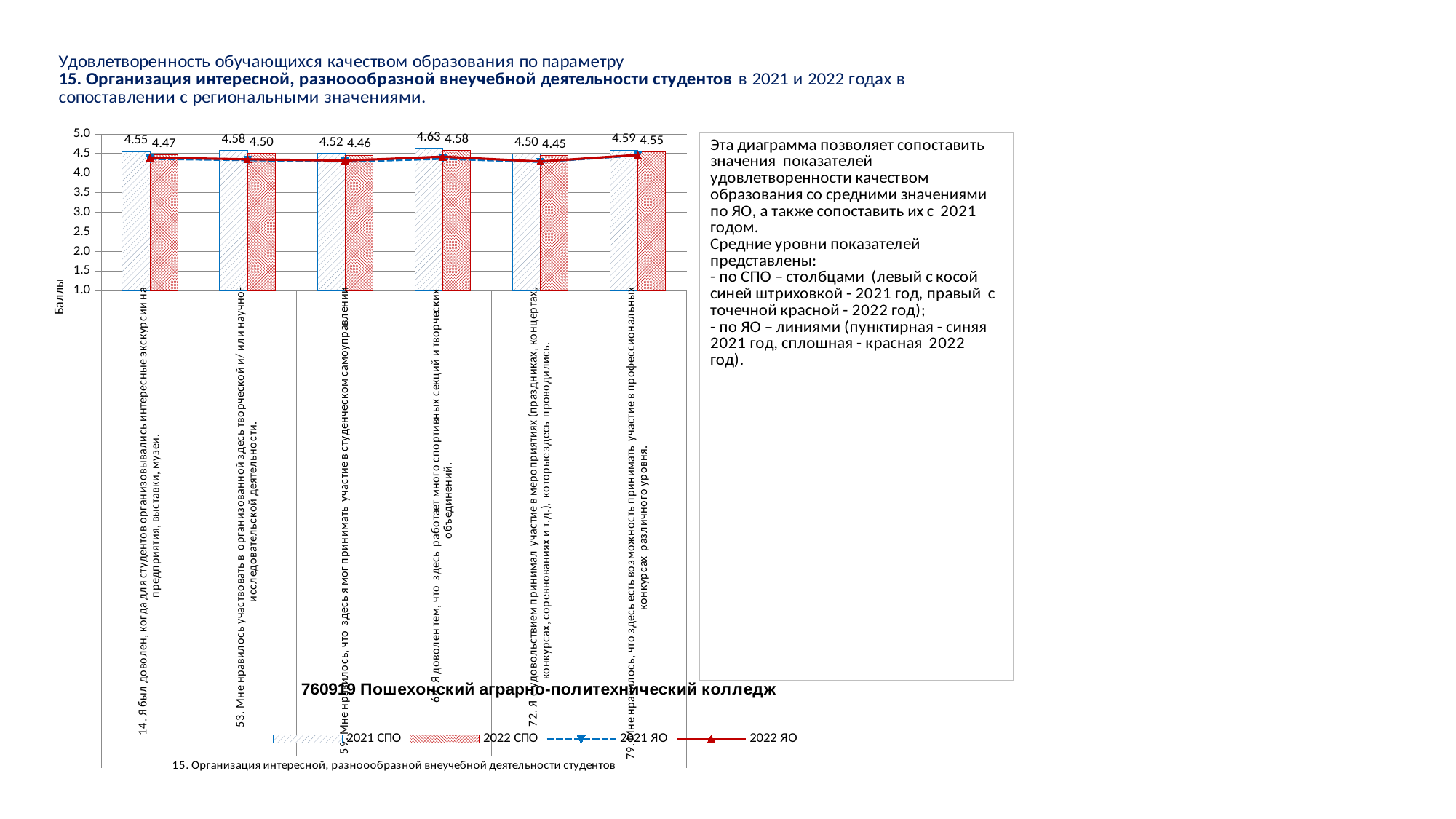
How many statements (categories) are shown on the x axis? 6 What is the difference between the 2021 СПО and 2022 СПО values for statement 53? 0.08 How many series does the legend list? 4 What kind of chart is shown on the slide? Combined bar and line chart What is the label of the vertical axis? Баллы Which statement has the lowest 2022 СПО value? 72. Я с удовольствием принимал участие в мероприятиях (праздниках, концертах, конкурсах, соревнованиях и т.д.), которые здесь проводились. Which statement has the highest 2021 СПО value? 64. Я доволен тем, что здесь работает много спортивных секций и творческих объединений. For statement 79, which is larger: the 2021 СПО value or the 2022 СПО value? 2021 СПО What is the 2021 СПО value for statement 14 (excursions to enterprises, exhibitions, museums)? 4.55 What is the 2022 СПО value for statement 72 (participation in events such as holidays, concerts, competitions)? 4.45